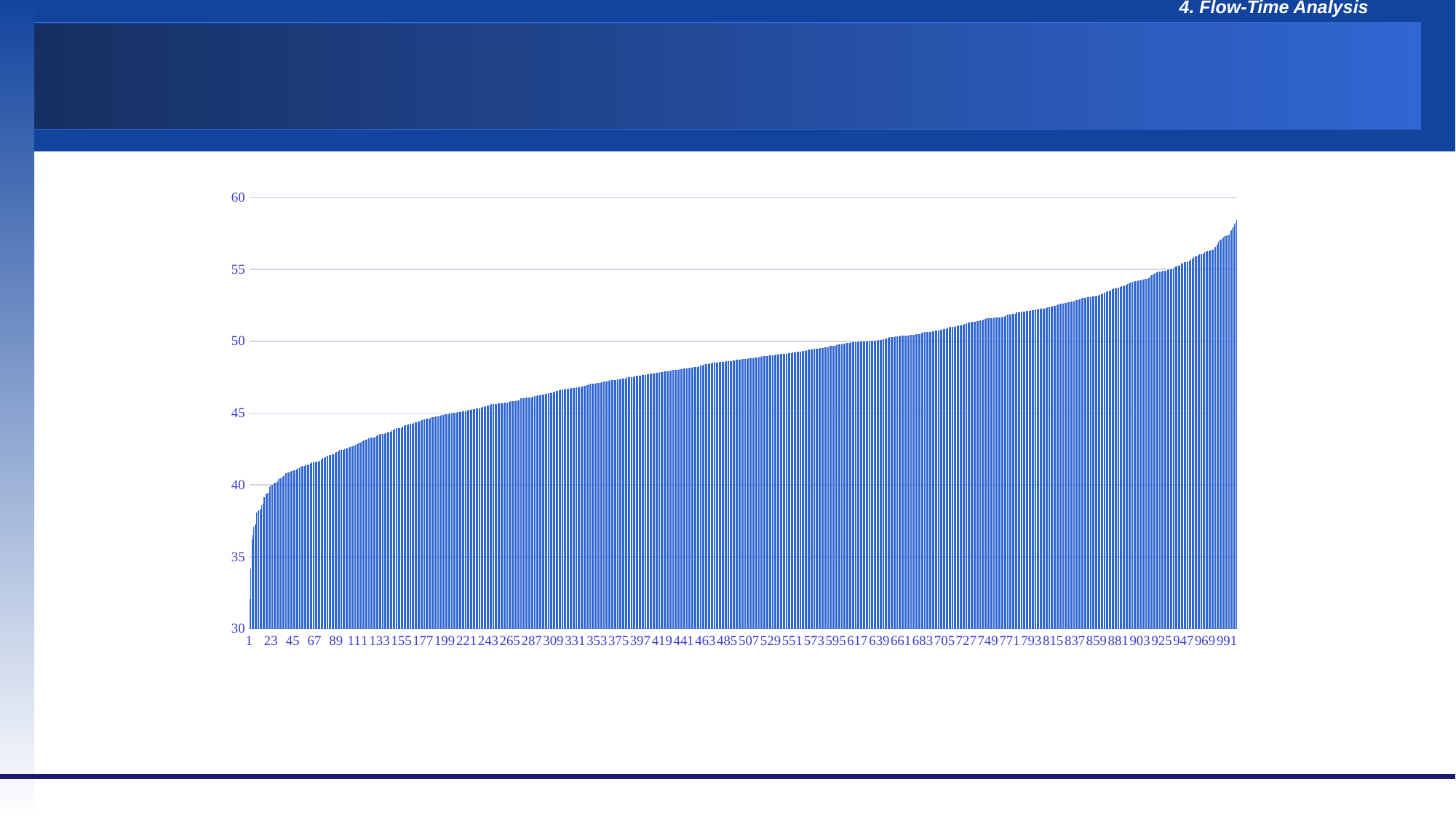
Is the value for category 23 greater or less than 45? less What is the lowest value shown on the y axis? 30 Is the value for category 991 greater or less than 55? greater Which has the larger value, category 1 or category 991? 991 Which has the larger value, category 133 or category 859? 859 Is the value for category 243 greater or less than 50? less What is the highest value shown on the y axis? 60 What kind of chart is shown on the slide? bar chart Do the bar values rise or fall as you move from left to right along the x axis? rise